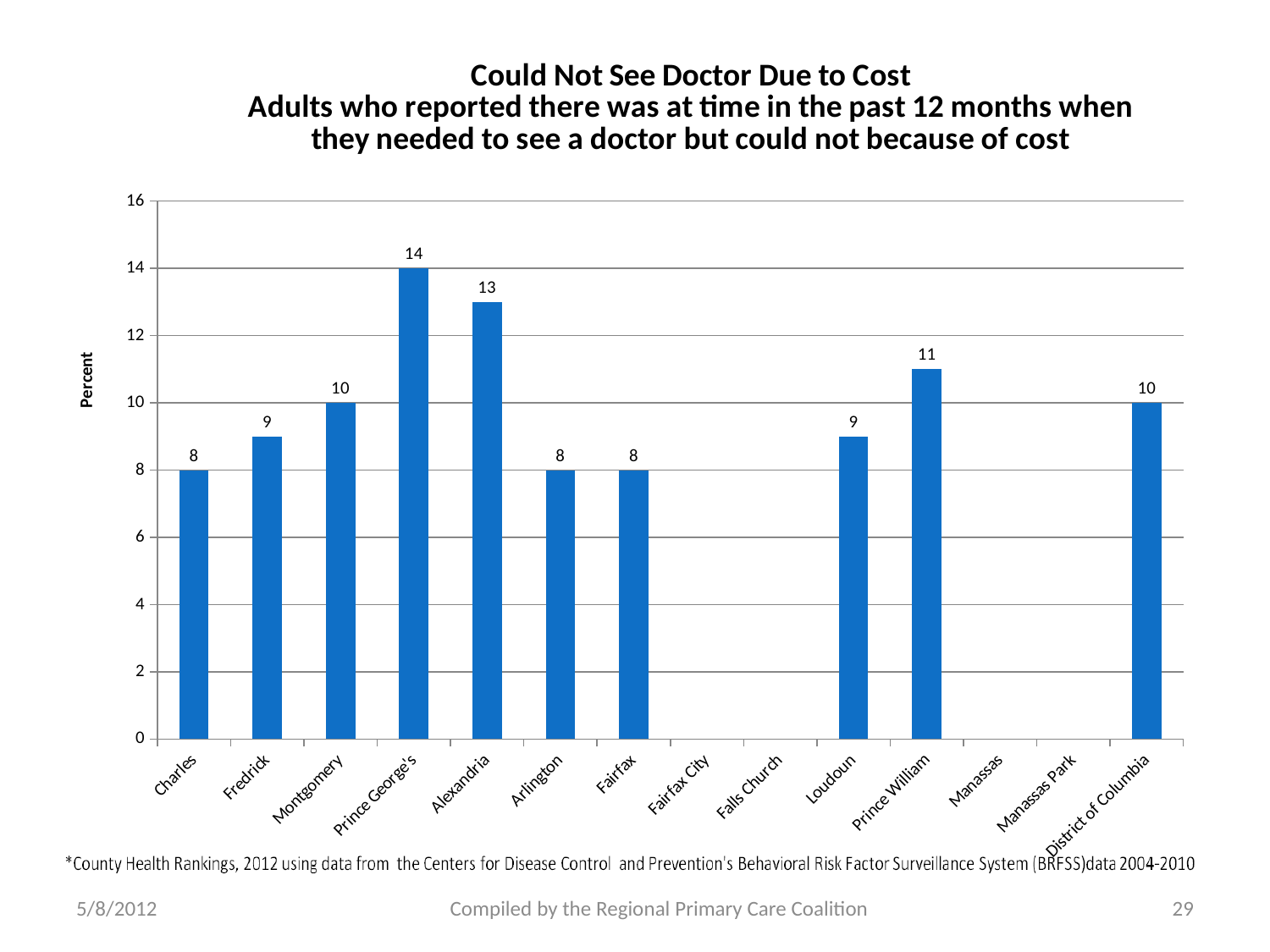
What is the value for Prince William? 11 What is the value for District of Columbia? 10 How many categories are listed along the x axis? 14 What is the difference between the values for Prince George's and Charles? 6 Which is larger, the value for Montgomery or the value for Prince William? Prince William What is the label on the vertical axis? Percent What is the value for Alexandria? 13 What is the difference between the values for Alexandria and Loudoun? 4 What kind of chart is shown on the slide? Bar chart Which is larger, the value for Fredrick or the value for Arlington? Fredrick Which category has the highest value? Prince George's What is the value for Prince George's? 14